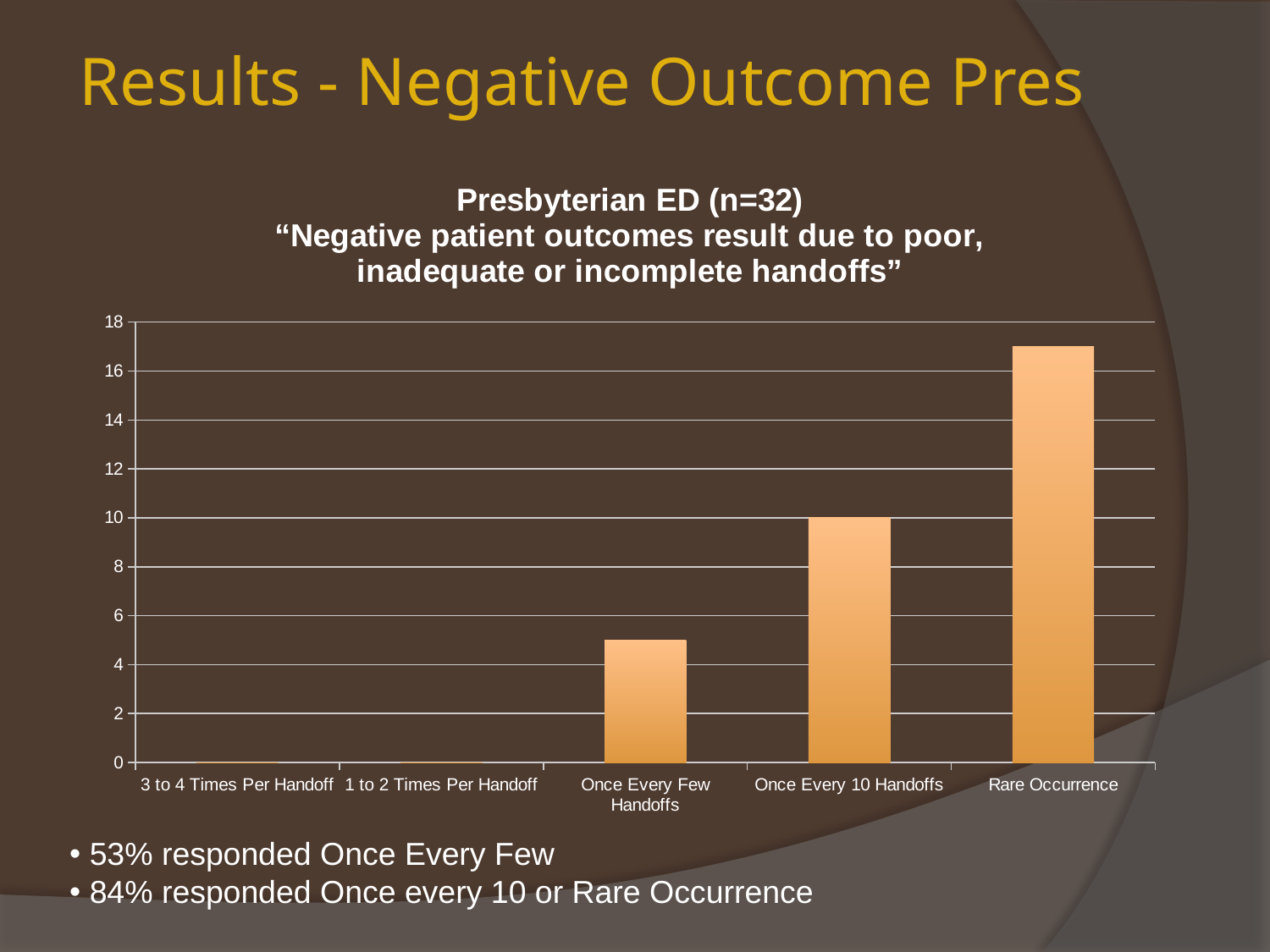
What is the value for Once Every 10 Handoffs? 10 Which is larger, the value for Rare Occurrence or the value for Once Every 10 Handoffs? Rare Occurrence Do the bar values rise or fall moving from left to right along the x axis? rise Is the value for Once Every Few Handoffs greater or less than 6? less What is the value for 1 to 2 Times Per Handoff? 0 Is the value for Rare Occurrence greater or less than 16? greater According to the chart title, what is the sample size (n) for Presbyterian ED? 32 How many categories are shown on the x axis of the chart? 5 What kind of chart is shown on the slide? bar chart Which category has the highest bar in the chart? Rare Occurrence Is the value for Once Every Few Handoffs greater or less than 4? greater What is the value for 3 to 4 Times Per Handoff? 0